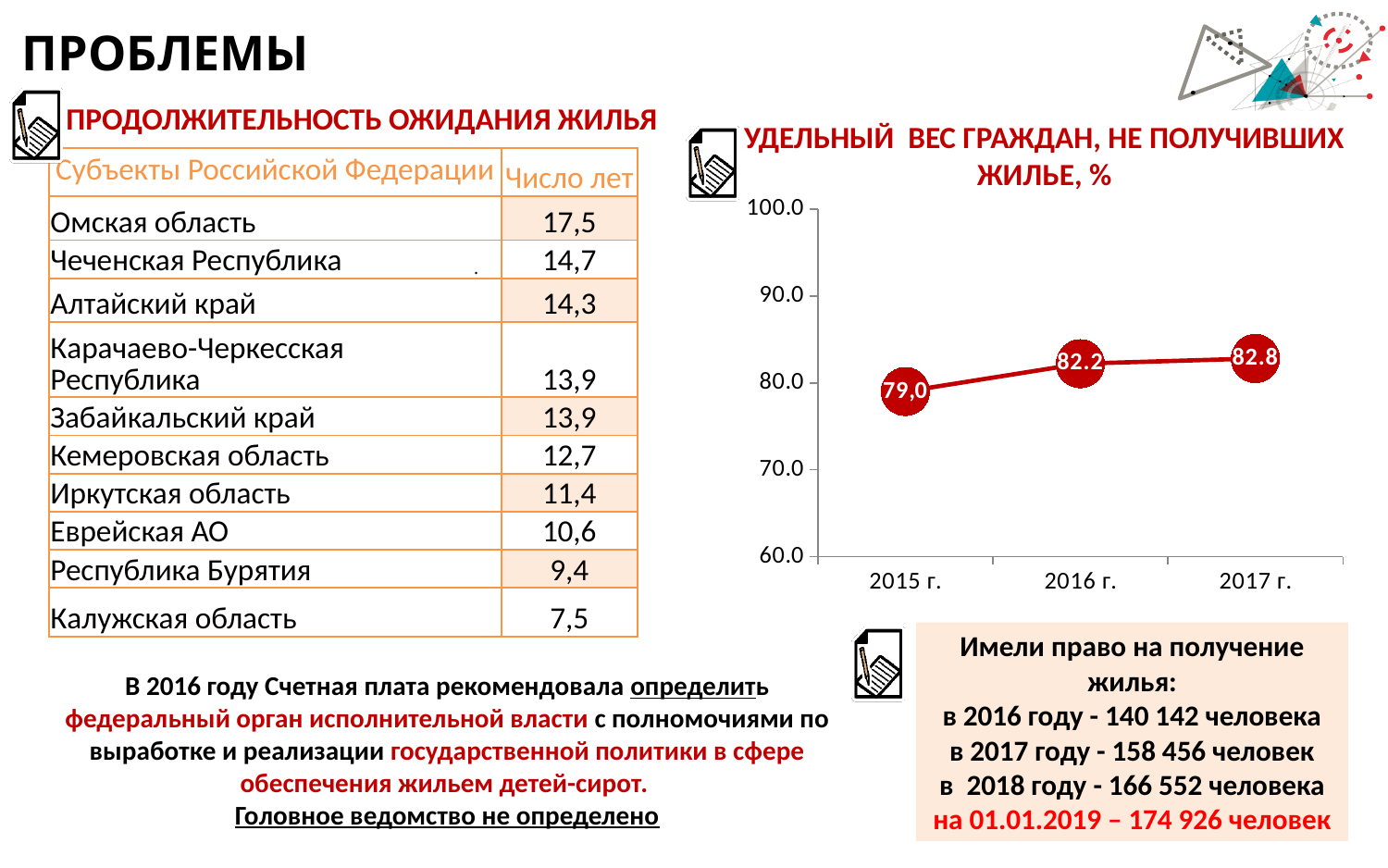
What type of chart is shown on the slide? line chart Which is larger, the value for 2016 г. or the value for 2017 г.? 2017 г. How many data points are plotted in the chart? 3 Which year has the lowest value in the chart? 2015 г. What is the value for 2016 г. in the chart? 82.2 What is the value for 2015 г. in the chart? 79,0 What is the difference between the values for 2017 г. and 2015 г.? 3.8 What is the difference between the values for 2016 г. and 2015 г.? 3.2 What is the title of the chart on the slide? УДЕЛЬНЫЙ ВЕС ГРАЖДАН, НЕ ПОЛУЧИВШИХ ЖИЛЬЕ, % Which year has the highest value in the chart? 2017 г. What is the value for 2017 г. in the chart? 82.8 Do the values in the chart rise or fall from 2015 г. to 2017 г.? rise